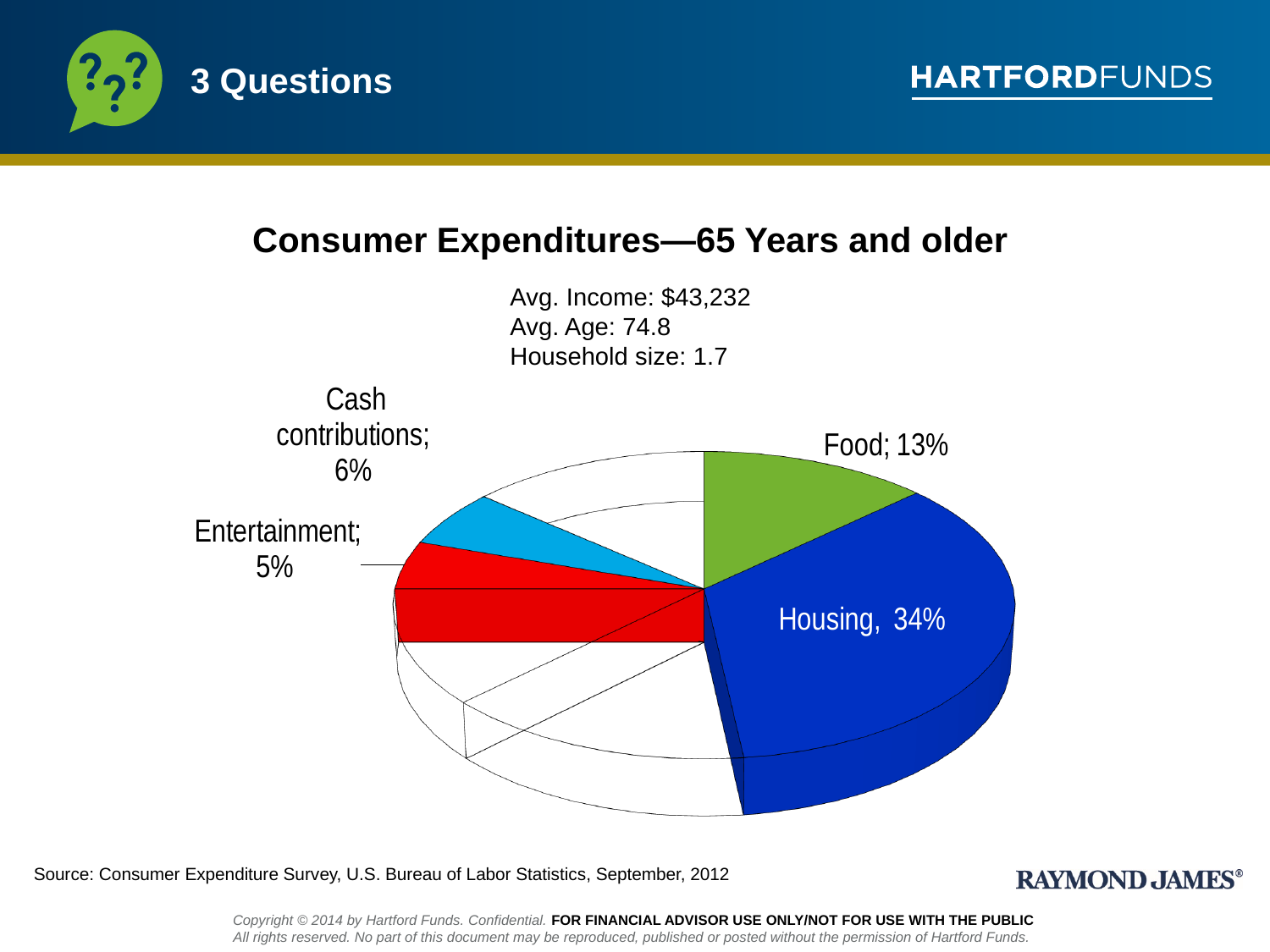
What colour is the Housing slice in the pie chart? Blue Which labeled category has the largest share of the pie chart? Housing What percentage of consumer expenditures for those 65 years and older goes to Housing? 34% What is the difference in percentage points between Cash contributions and Entertainment? 1 percentage point What percentage does the pie chart show for Entertainment? 5% How many percentage points larger is the Housing share than the Food share? 21 percentage points What is the title of the chart on the slide? Consumer Expenditures—65 Years and older What type of chart is used on this slide? Pie chart Which is smaller, the share for Entertainment or the share for Cash contributions? Entertainment What percentage does the pie chart show for Cash contributions? 6% What share of expenditures is labeled for Food in the pie chart? 13% Which is larger, the share for Food or the share for Entertainment? Food